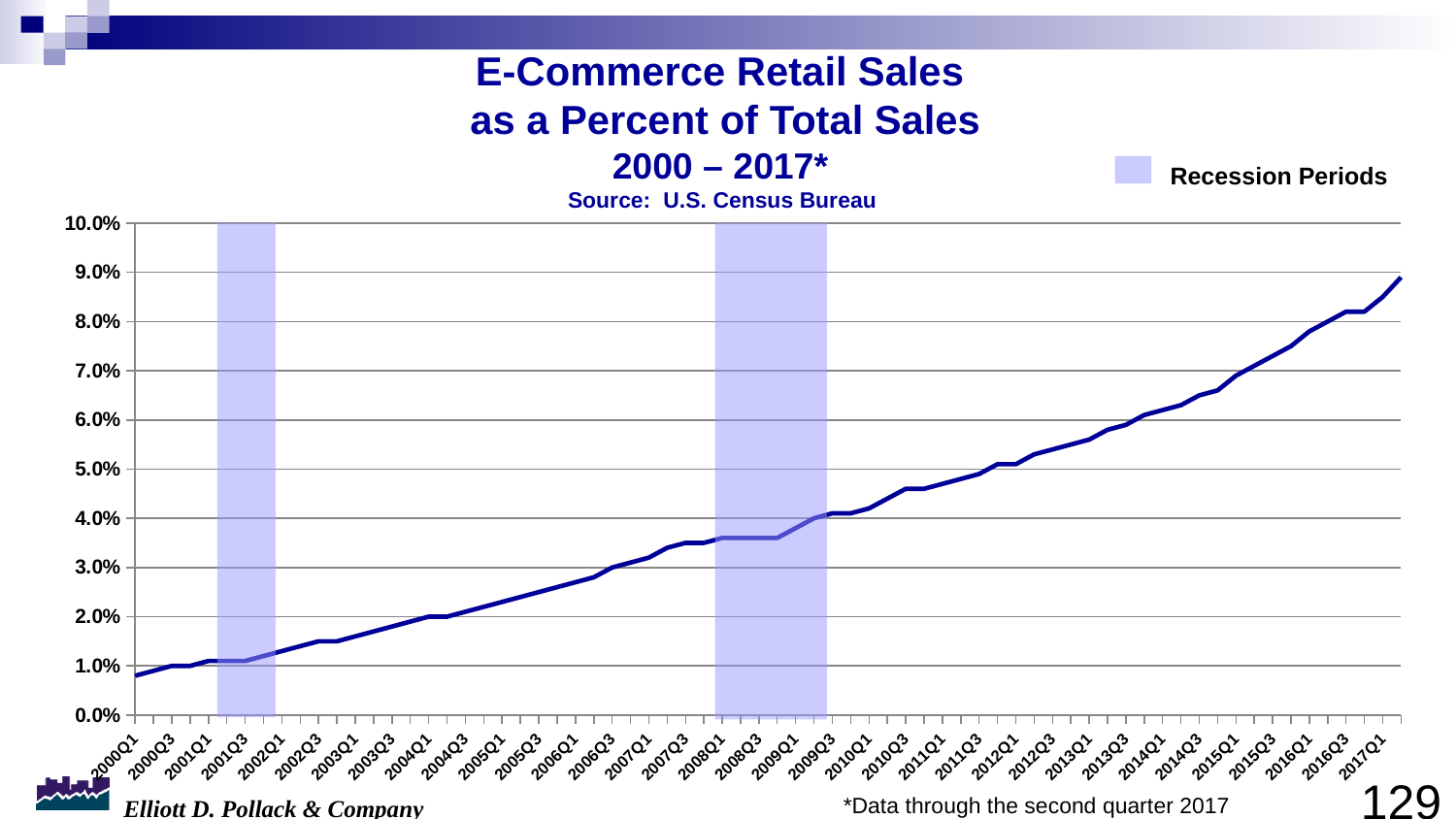
Is the value for 2008Q1 greater or less than 4.0%? less What is the source of the data cited on the slide? U.S. Census Bureau What do the shaded vertical bands on the chart represent? Recession Periods Which is larger, the value for 2010Q1 or the value for 2005Q1? 2010Q1 Is the value for 2017Q1 greater or less than 8.0%? greater Is the value for 2000Q1 greater or less than 1.0%? less Do e-commerce retail sales as a percent of total sales generally rise or fall from 2000Q1 to 2017? rise Which is larger, the value for 2002Q1 or the value for 2015Q1? 2015Q1 What kind of chart is shown on the slide? line chart